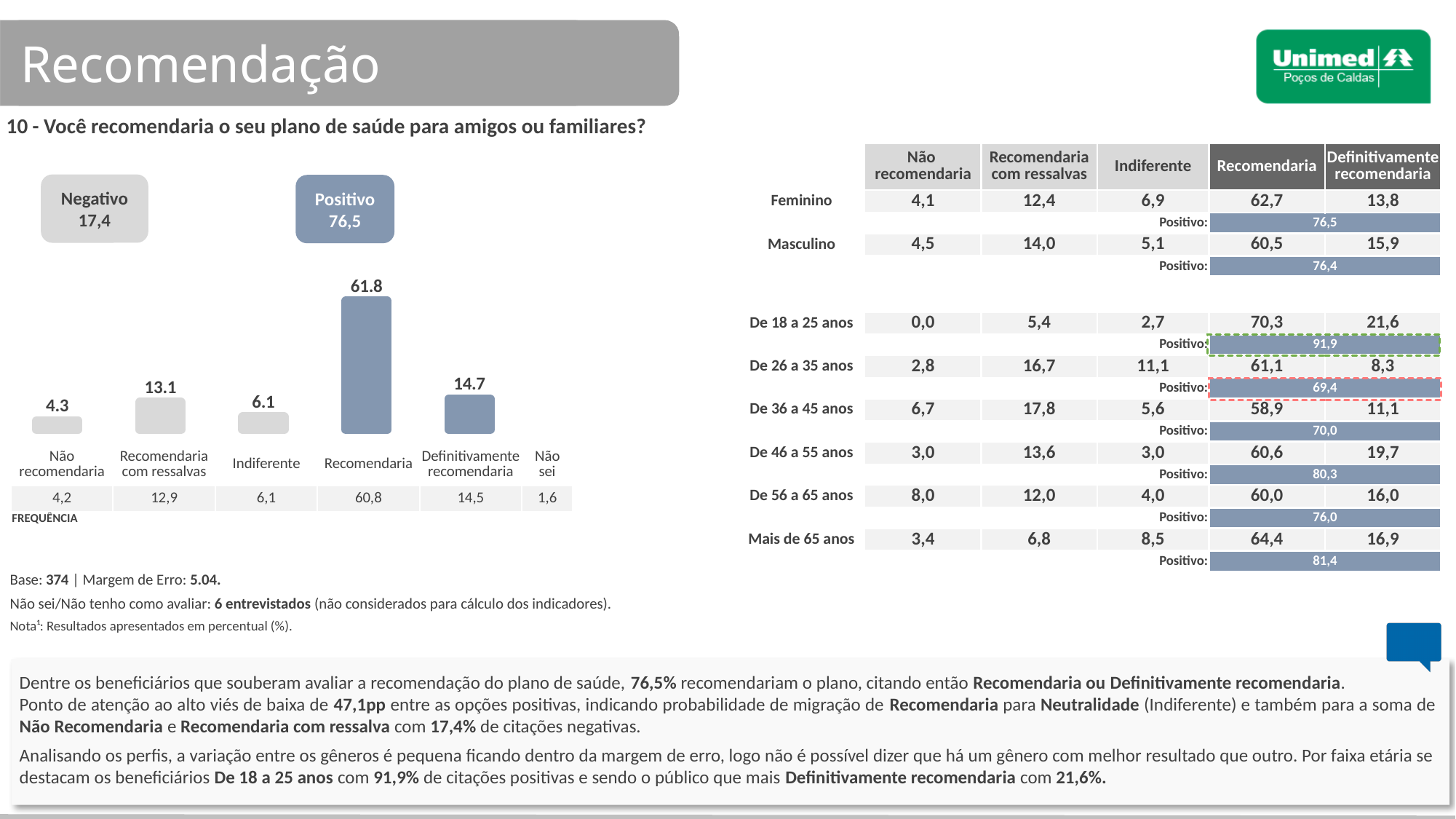
In the bar chart, what is the difference between the values for "Definitivamente recomendaria" and "Indiferente"? 8.6 In the bar chart, what is the difference between the values for "Recomendaria" and "Definitivamente recomendaria"? 47.1 In the bar chart, what is the value shown for "Indiferente"? 6.1 In the bar chart, what is the value shown for "Não recomendaria"? 4.3 What type of chart is shown on the left of the slide? Bar chart In the bar chart, what is the value shown for "Definitivamente recomendaria"? 14.7 How many bars are plotted in the bar chart? 5 What value is shown in the "Positivo" box above the bar chart? 76,5 Which category has the lowest bar in the bar chart? Não recomendaria Which category has the highest bar in the bar chart? Recomendaria In the bar chart, what is the value shown for "Recomendaria"? 61.8 In the bar chart, which is larger: "Recomendaria com ressalvas" or "Definitivamente recomendaria"? Definitivamente recomendaria